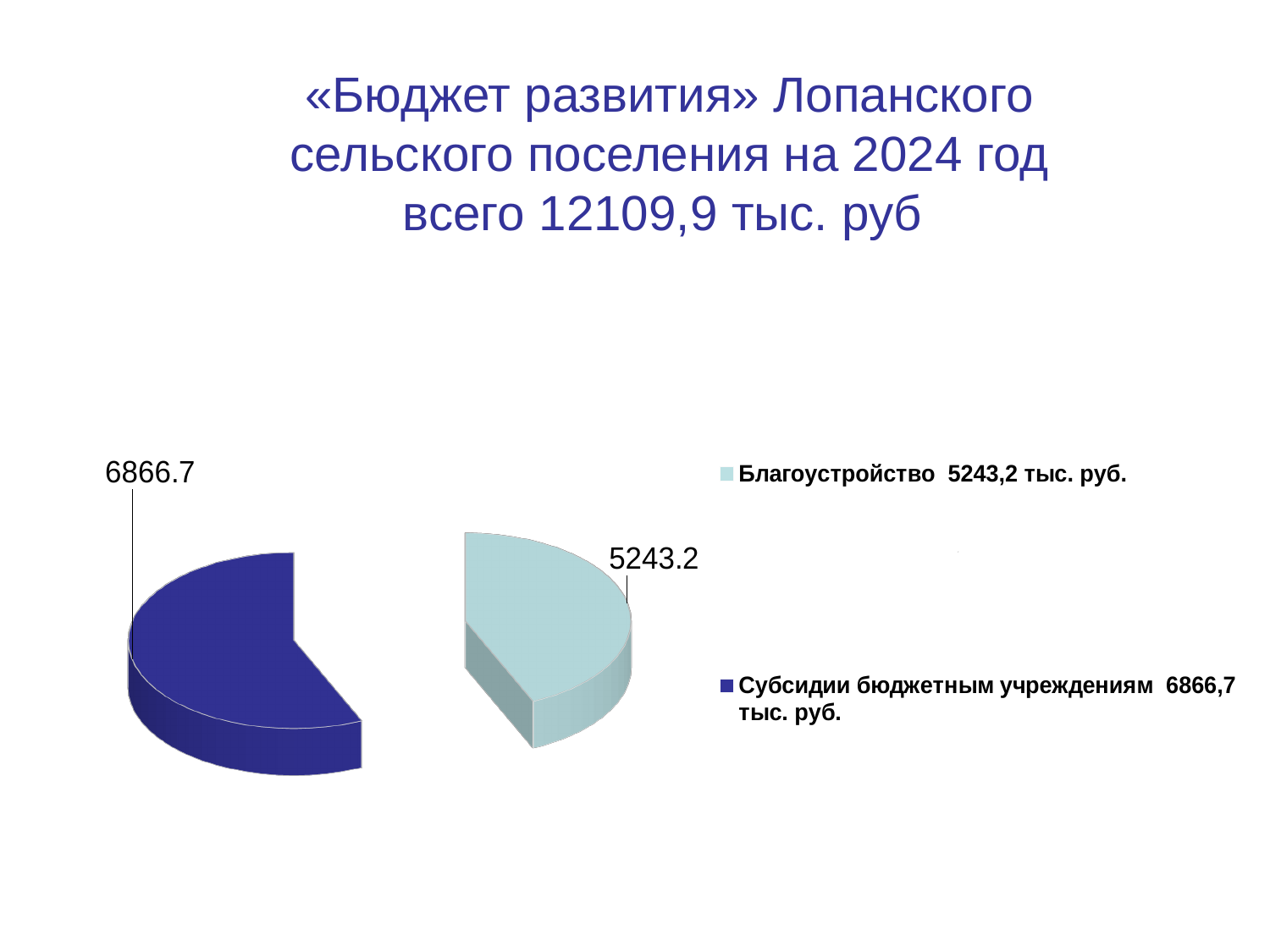
What is the difference between the values for Субсидии бюджетным учреждениям and Благоустройство? 1623.5 What colour is the slice for Благоустройство? Light blue What type of chart is shown on the slide? Pie chart What is the total of the two slices in the pie chart? 12109.9 How many slices does the pie chart have? 2 Which category has the smallest slice of the pie? Благоустройство Which category has the largest slice of the pie? Субсидии бюджетным учреждениям Which is larger: Благоустройство or Субсидии бюджетным учреждениям? Субсидии бюджетным учреждениям What is the value for Благоустройство? 5243.2 How many entries does the legend list? 2 What is the value for Субсидии бюджетным учреждениям? 6866.7